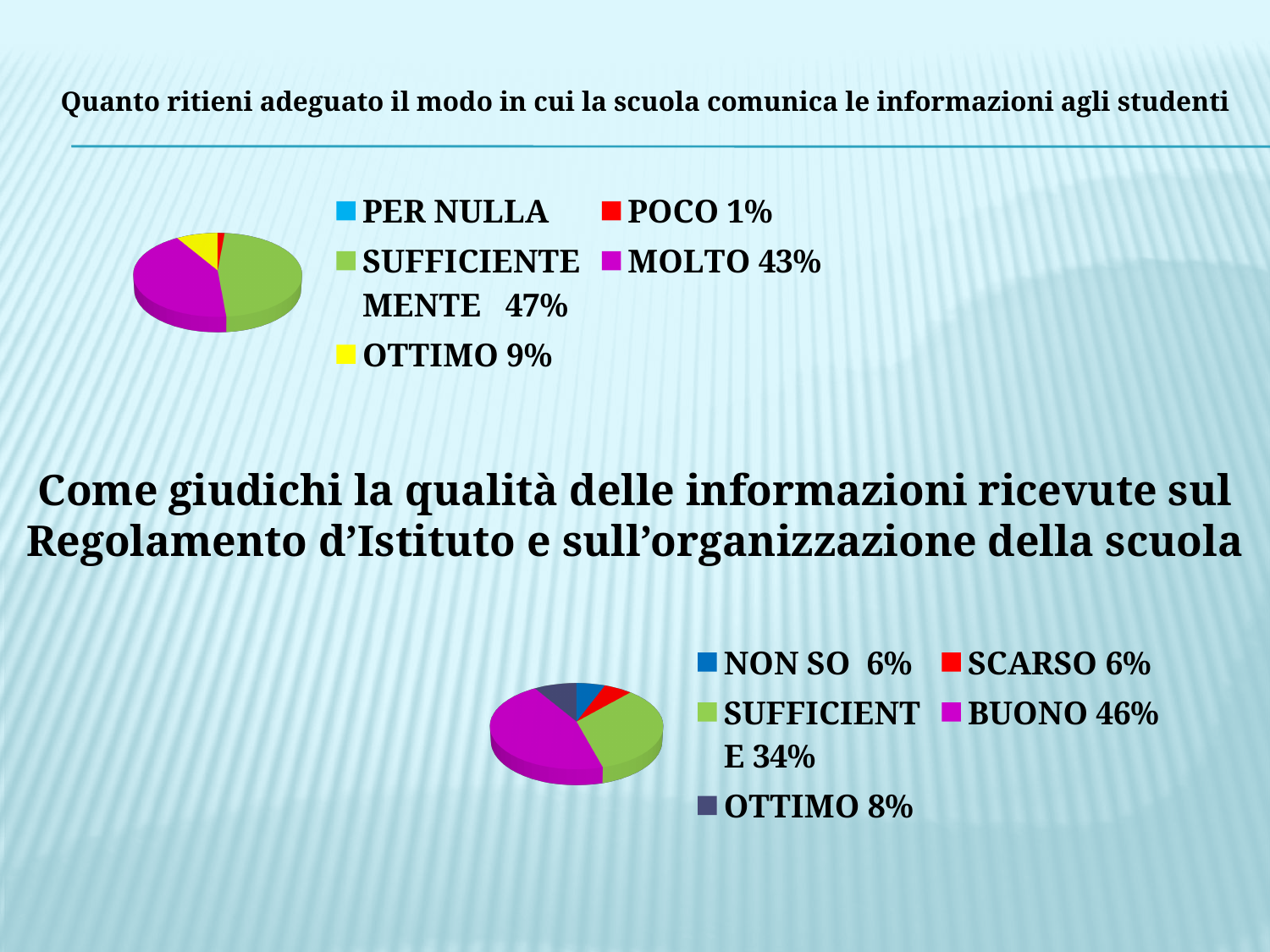
In the top chart, how many entries does the legend list? 5 In the top chart, which category with a printed value has the smallest share? POCO In the top chart, what percentage is shown for OTTIMO? 9% What type of chart is used for both charts on the slide? Pie chart In the bottom chart, what percentage is shown for SUFFICIENTE? 34% In the top chart, what is the difference between the SUFFICIENTEMENTE and MOLTO percentages? 4% In the top chart, which category has the largest share? SUFFICIENTEMENTE In the bottom chart, which category has the largest share? BUONO In the top chart (Quanto ritieni adeguato il modo in cui la scuola comunica le informazioni agli studenti), what percentage is shown for MOLTO? 43% In the bottom chart, which is larger, OTTIMO or SCARSO? OTTIMO In the bottom chart (Come giudichi la qualità delle informazioni ricevute sul Regolamento d'Istituto), what percentage is shown for BUONO? 46% In the top chart, what percentage is shown for SUFFICIENTEMENTE? 47%